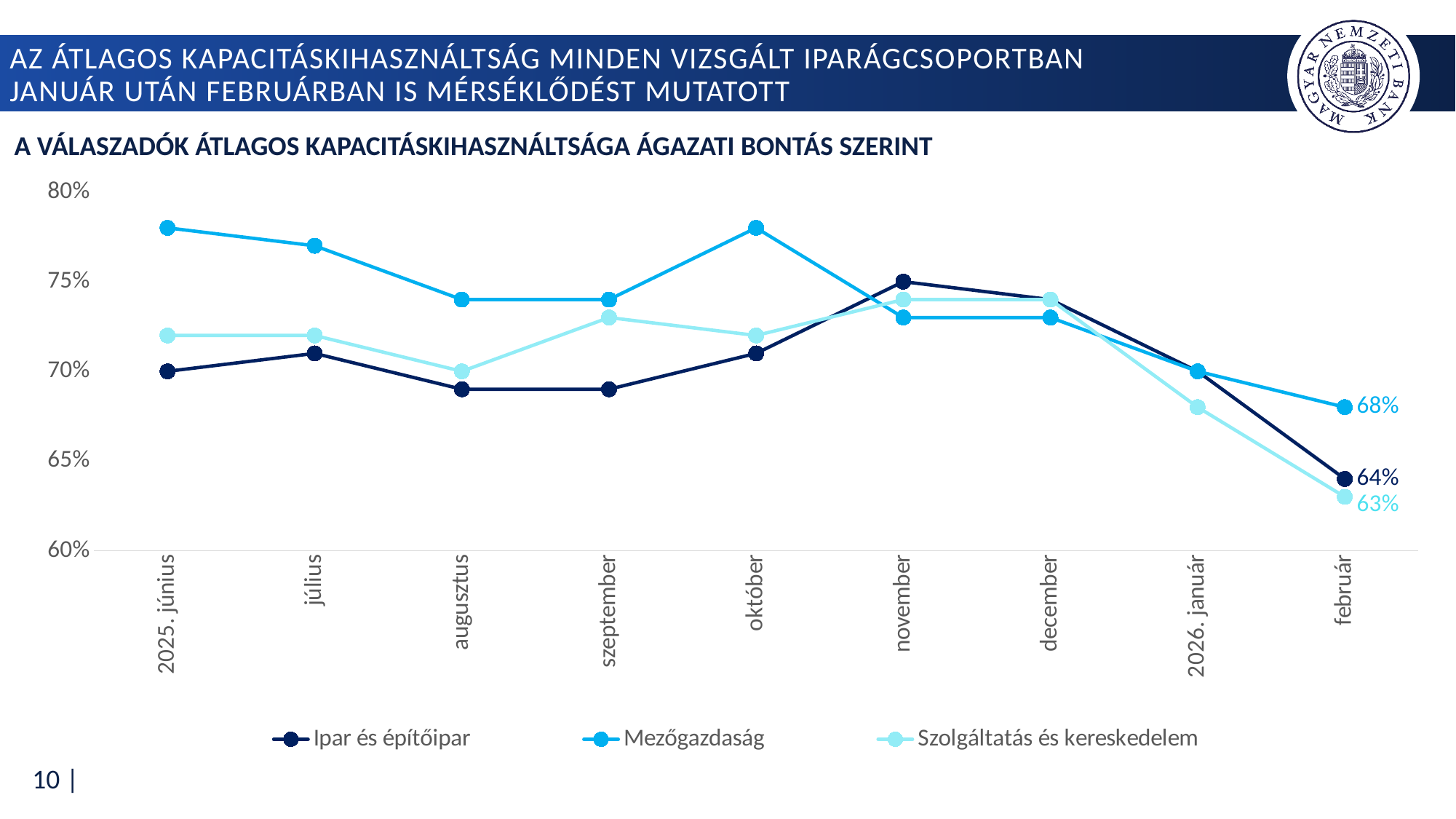
How many months are shown on the x axis? 9 Does the Ipar és építőipar line rise or fall from december to február? fall What is the value for Ipar és építőipar in február? 64% How many series does the legend list? 3 What is the difference between the február values of Mezőgazdaság and Szolgáltatás és kereskedelem? 5 percentage points What is the value for Szolgáltatás és kereskedelem in február? 63% In február, which is larger: Ipar és építőipar or Szolgáltatás és kereskedelem? Ipar és építőipar Is the value for Ipar és építőipar in augusztus greater or less than 70%? less Is the value for Mezőgazdaság in 2025. június greater or less than 75%? greater Which series has the highest value in február? Mezőgazdaság What is the value for Mezőgazdaság in február? 68% Which series has the lowest value in február? Szolgáltatás és kereskedelem